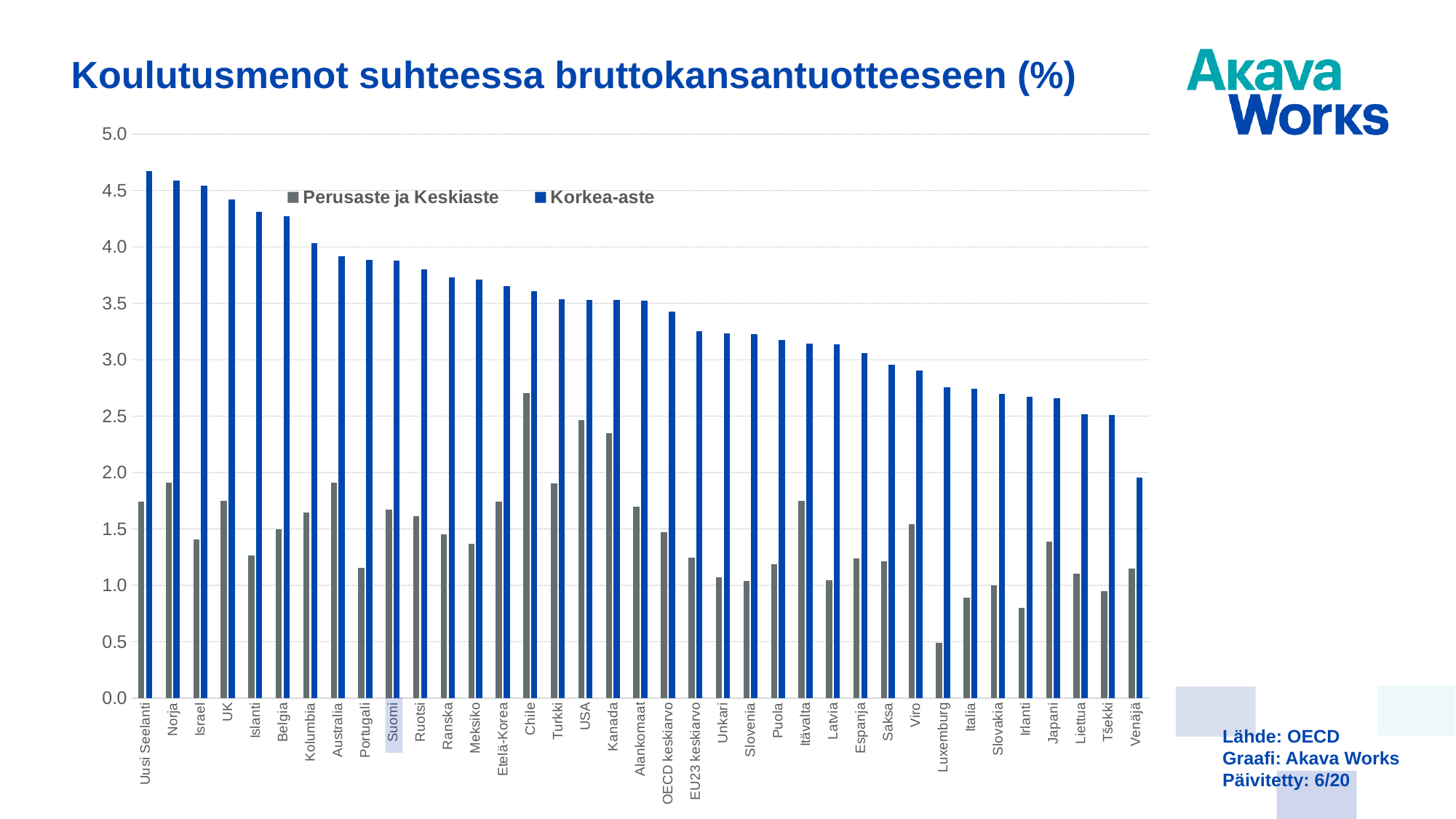
Do the Korkea-aste values rise or fall from left to right along the x axis? fall How many series does the legend list? 2 Is the Korkea-aste value for Suomi greater or less than 3.5? greater Which country has the lowest Korkea-aste value? Venäjä Which country has the highest Perusaste ja Keskiaste value? Chile Which country has the highest Korkea-aste value? Uusi Seelanti Is the Korkea-aste value for Belgia greater or less than 4.5? less How many countries or groups are shown on the x axis? 37 Which is larger, the Perusaste ja Keskiaste value for Chile or for USA? Chile Which country has the lowest Perusaste ja Keskiaste value? Luxemburg What kind of chart is shown on the slide? bar chart Is the Korkea-aste value for Uusi Seelanti greater or less than 4.5? greater